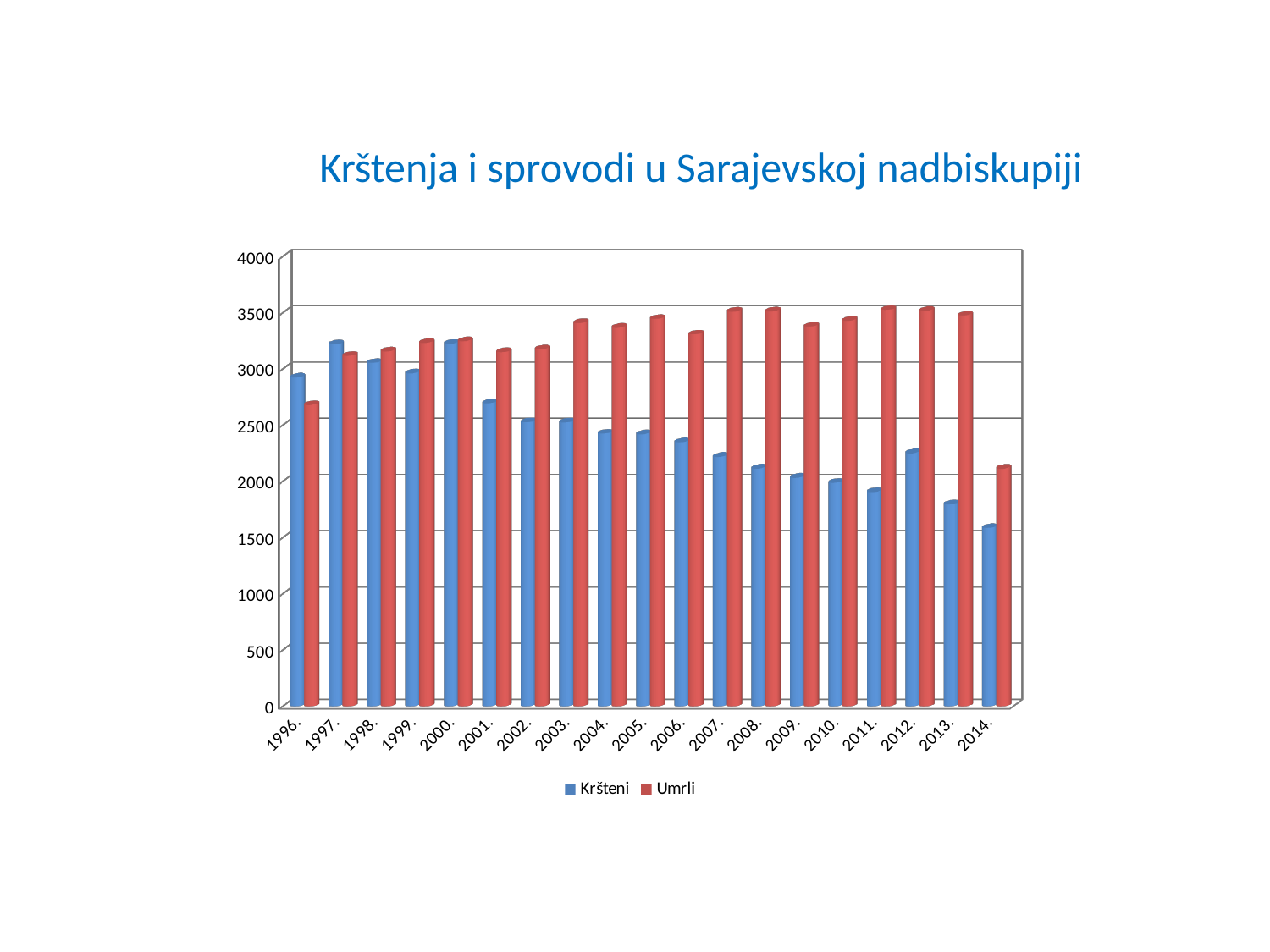
Is the value for Kršteni in 1996. greater or less than 3000? less Is the value for Kršteni in 2014. greater or less than 2000? less Is the value for Umrli in 2003. greater or less than 3000? greater What kind of chart is shown on the slide? bar chart In 1996., which is larger, Kršteni or Umrli? Kršteni How many series does the legend list? 2 Which year has the lowest value for Kršteni? 2014. How many years are shown on the x axis? 19 In 2005., which is larger, Kršteni or Umrli? Umrli Do the values for Kršteni generally rise or fall from 1996. to 2014.? fall Which year has the lowest value for Umrli? 2014.